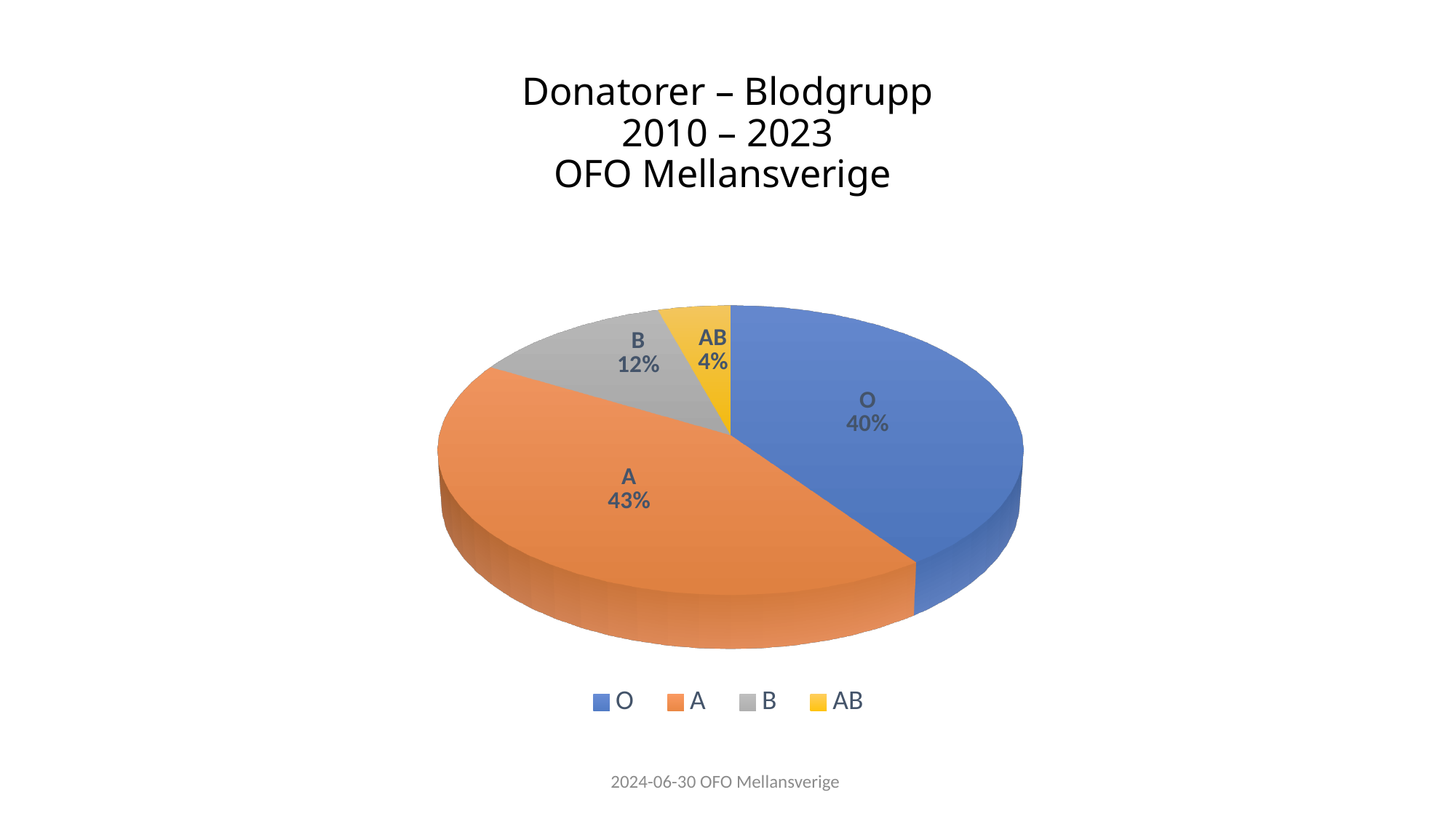
What is the value shown for blood group AB? 4% How many blood groups are shown in the pie chart? 4 What kind of chart is shown on the slide? Pie chart What colour is the slice for blood group O? Blue Which is larger, the slice for B or the slice for AB? B What is the difference in percentage points between blood group B and blood group AB? 8% What share of the pie does blood group O have? 40% What is the difference in percentage points between blood group A and blood group O? 3% What share of the pie does blood group A have? 43% Which blood group has the smallest slice of the pie? AB What is the value shown for blood group B? 12% Which blood group has the largest slice of the pie? A